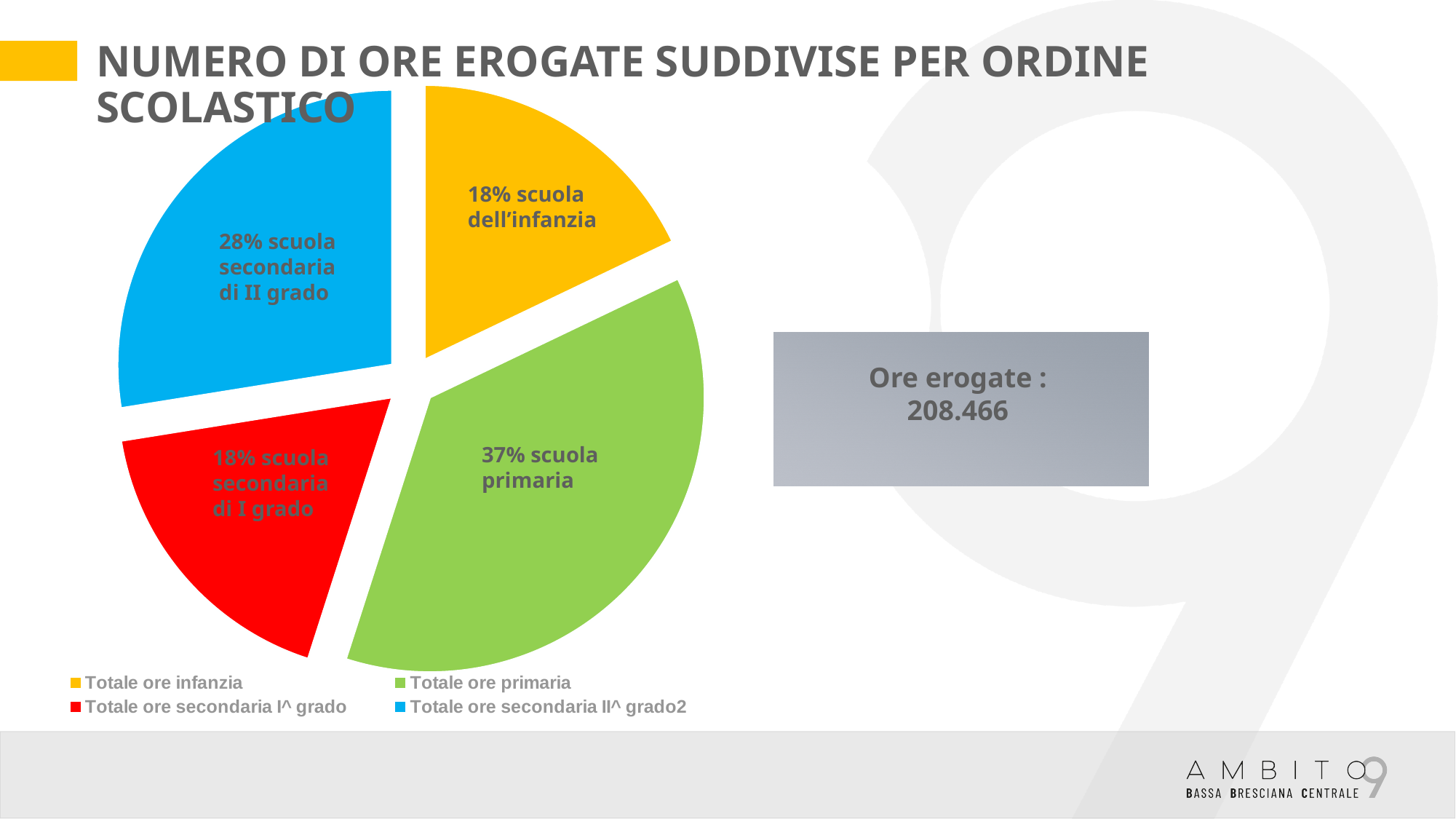
What share of the pie does scuola secondaria di I grado have? 18% What share of the pie does scuola dell'infanzia have? 18% What is the difference in percentage points between the scuola primaria slice and the scuola secondaria di II grado slice? 9 percentage points What is the total number of ore erogate shown in the box next to the chart? 208.466 What share of the pie does scuola primaria have? 37% What kind of chart is shown on the slide? pie chart Which school level has the largest slice of the pie? scuola primaria How many slices does the pie chart have? 4 How many entries does the legend list? 4 Which is larger, the slice for scuola secondaria di II grado or the slice for scuola dell'infanzia? scuola secondaria di II grado What colour is the slice for Totale ore primaria? green